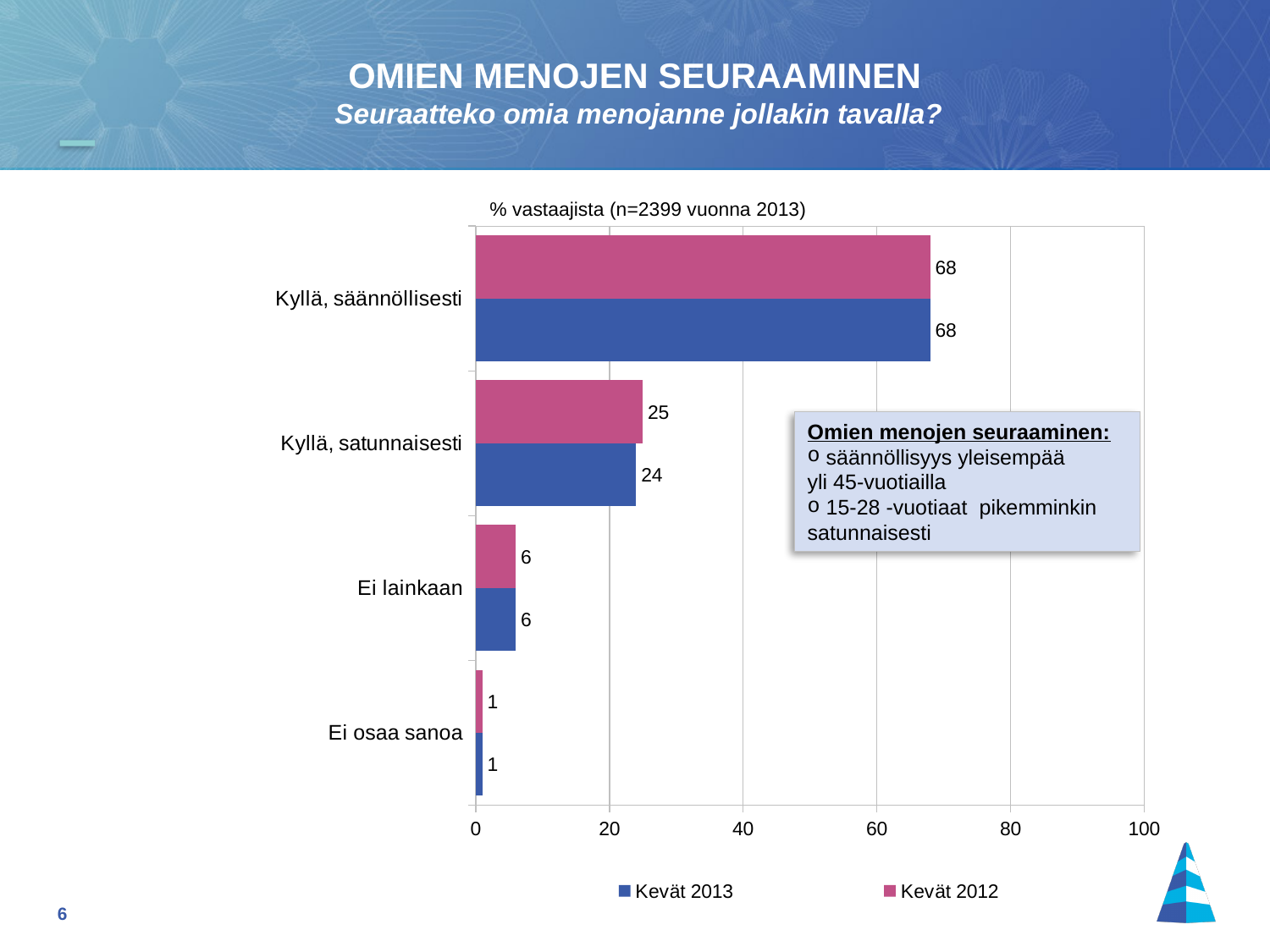
How many categories are shown on the chart? 4 What is the value for "Kyllä, säännöllisesti" in the Kevät 2013 series? 68 What is the value for "Kyllä, satunnaisesti" in the Kevät 2012 series? 25 What is the value for "Ei osaa sanoa" in the Kevät 2012 series? 1 How many series does the legend list? 2 What is the difference between the Kevät 2013 values for "Kyllä, säännöllisesti" and "Kyllä, satunnaisesti"? 44 What kind of chart is shown on the slide? Bar chart What is the value for "Ei lainkaan" in the Kevät 2013 series? 6 Which category has the lowest value in the Kevät 2012 series? Ei osaa sanoa Which is larger for "Kyllä, satunnaisesti": the Kevät 2012 value or the Kevät 2013 value? Kevät 2012 What is the value for "Kyllä, satunnaisesti" in the Kevät 2013 series? 24 Which category has the highest value in the Kevät 2013 series? Kyllä, säännöllisesti